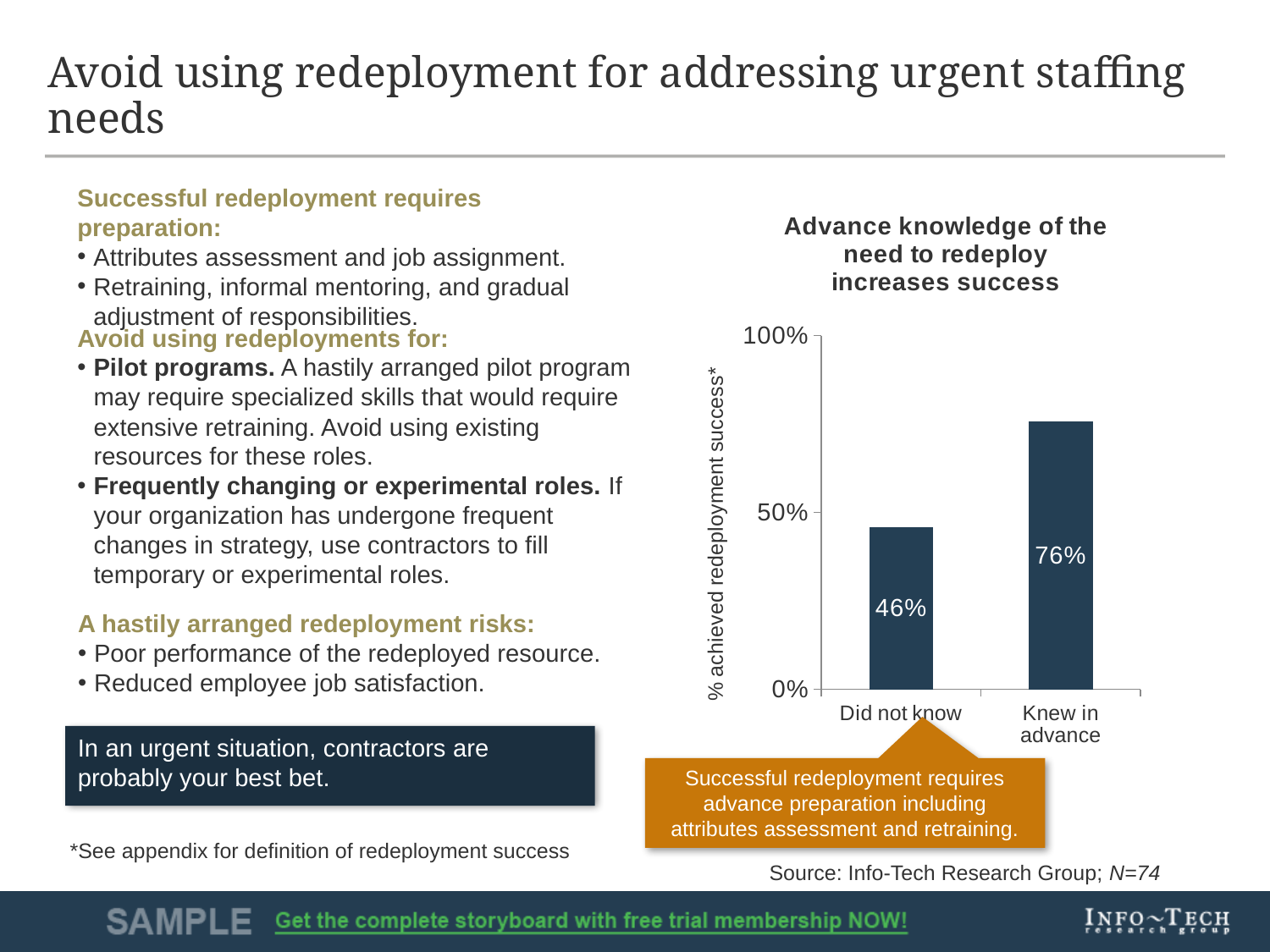
What is the label of the chart's y axis? % achieved redeployment success* Which category has the higher redeployment success rate? Knew in advance Is the redeployment success rate for 'Did not know' greater or less than 50%? less Which category has the lower redeployment success rate? Did not know What percentage achieved redeployment success among those who did not know in advance? 46% Is the redeployment success rate for 'Knew in advance' greater or less than 50%? greater What type of chart is shown on the slide? Bar chart How many categories are shown on the chart's x axis? 2 What is the sample size (N) given in the chart's source note? N=74 What is the title of the chart? Advance knowledge of the need to redeploy increases success What is the difference in redeployment success between 'Knew in advance' and 'Did not know'? 30% What percentage achieved redeployment success among those who knew in advance? 76%